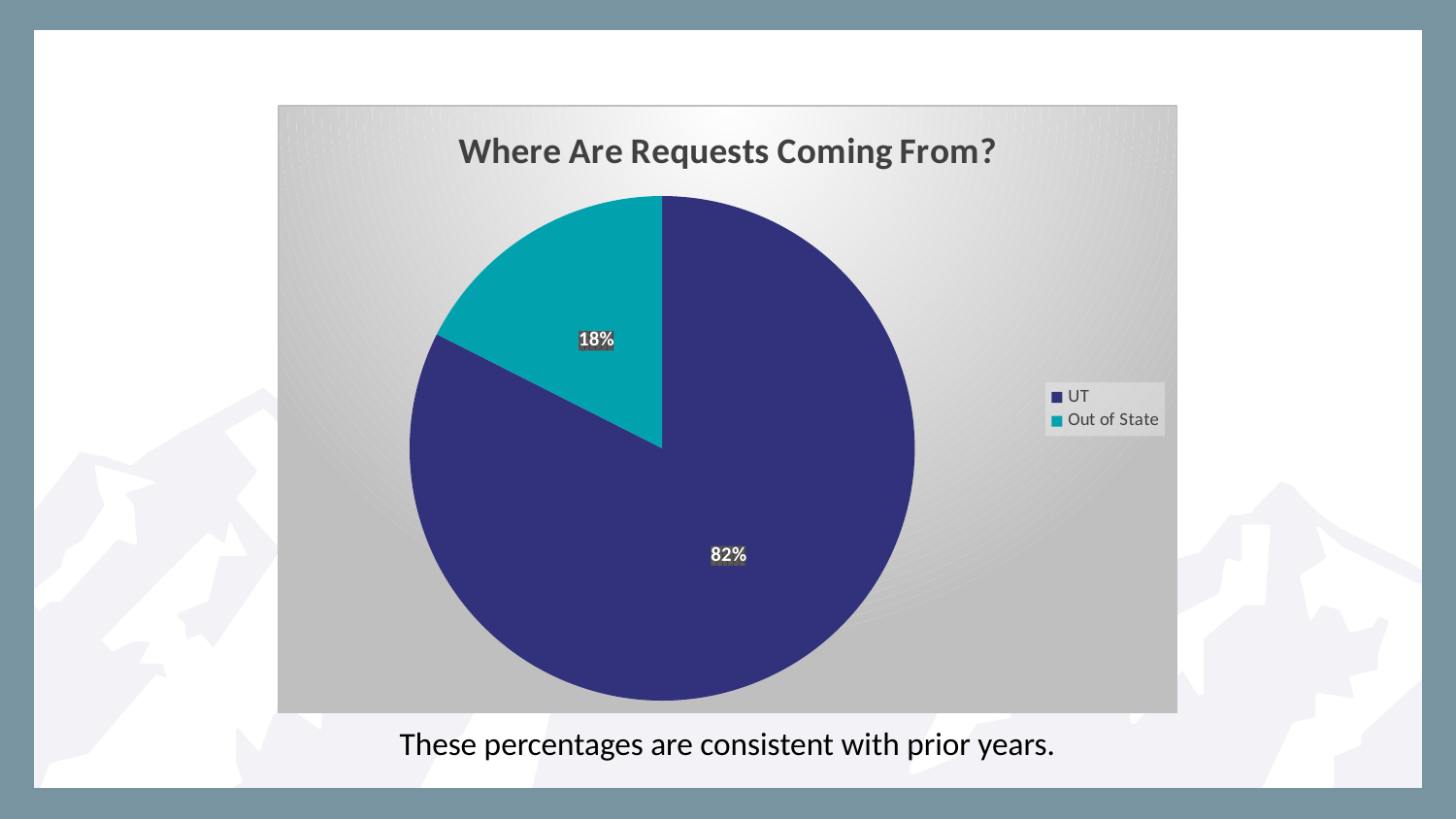
Which is larger, the share for UT or the share for Out of State? UT Which category has the largest share of the pie? UT Which category has the smallest share of the pie? Out of State What kind of chart is shown on the slide? pie chart What percentage of requests come from UT? 82% What is the difference in percentage points between the UT share and the Out of State share? 64 What is the title of the chart? Where Are Requests Coming From? What percentage of requests come from Out of State? 18% What share of the pie does the Out of State slice represent? 18% How many entries does the legend list? 2 How many slices does the pie chart have? 2 Which legend entry is shown in teal? Out of State